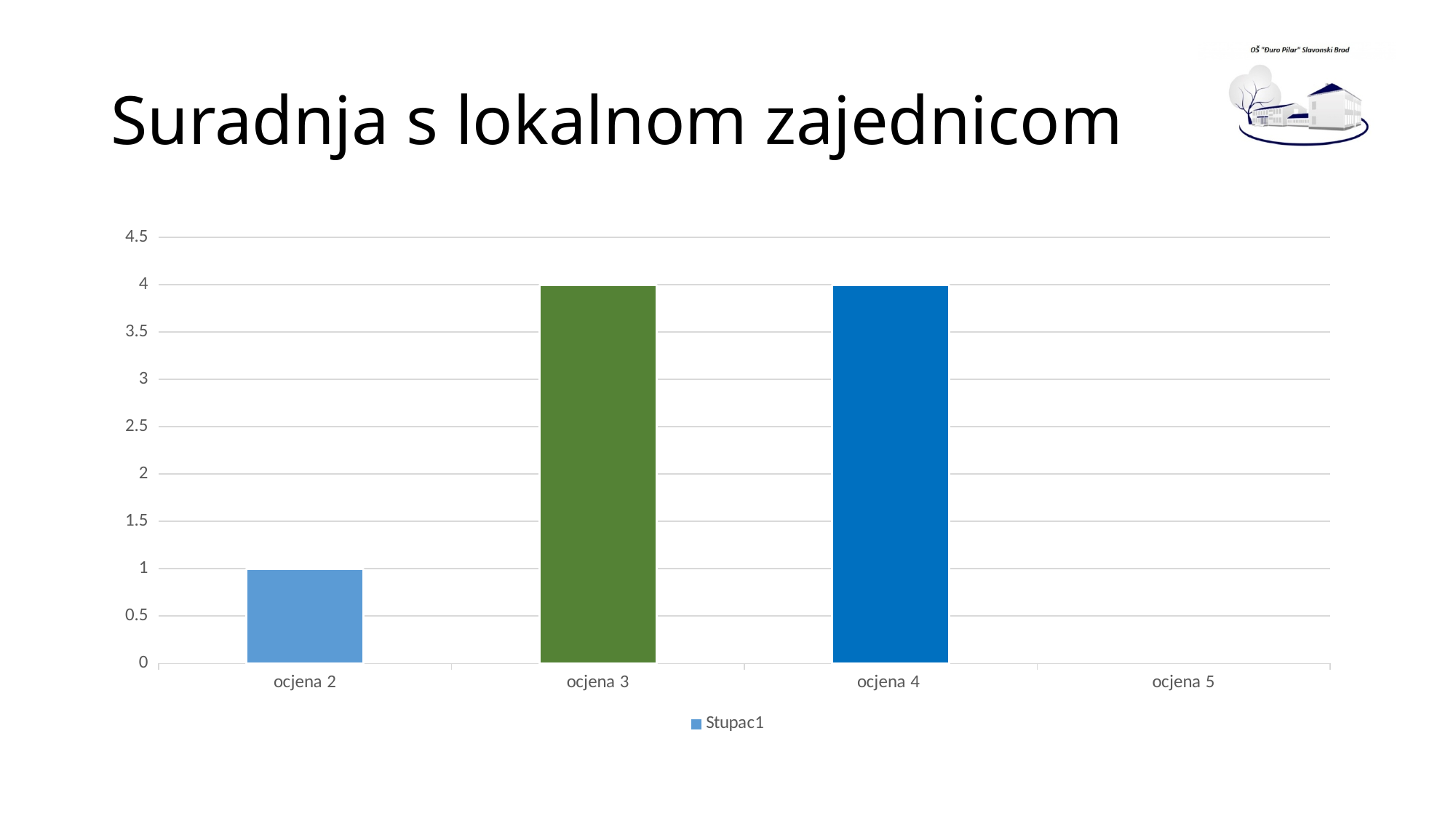
What is the difference between the values for ocjena 3 and ocjena 2? 3 Which is larger, the value for ocjena 2 or the value for ocjena 4? ocjena 4 Is the value for ocjena 3 greater or less than 3? greater How many series does the legend list? 1 What is the value for ocjena 2? 1 What is the name of the series in the legend? Stupac1 What is the value for ocjena 3? 4 How many categories are shown on the x axis? 4 What is the value for ocjena 4? 4 Is the value for ocjena 2 greater or less than 2? less What kind of chart is shown on the slide? bar chart